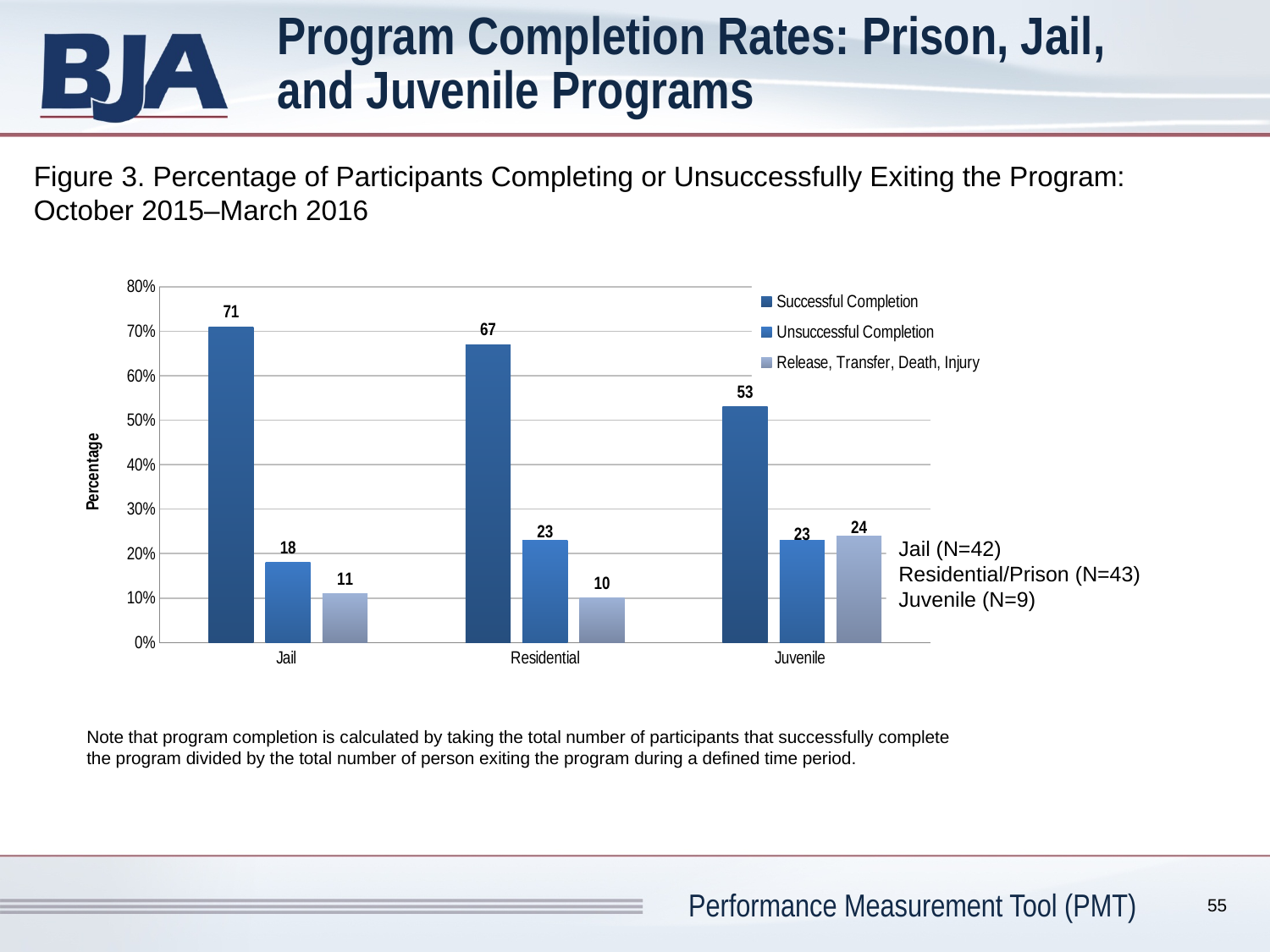
What is the label of the y axis? Percentage What is the Successful Completion value for Jail? 71 What is the difference between the Successful Completion values for Jail and Juvenile? 18 Which is larger, the Unsuccessful Completion value for Jail or for Juvenile? Juvenile Which category has the highest Successful Completion value? Jail What is the Unsuccessful Completion value for Residential? 23 Which category has the lowest Release, Transfer, Death, Injury value? Residential How many categories are shown on the x axis? 3 What is the Release, Transfer, Death, Injury value for Juvenile? 24 What kind of chart is shown? bar chart How many series does the legend list? 3 Does the Successful Completion value rise or fall from Jail to Juvenile? fall